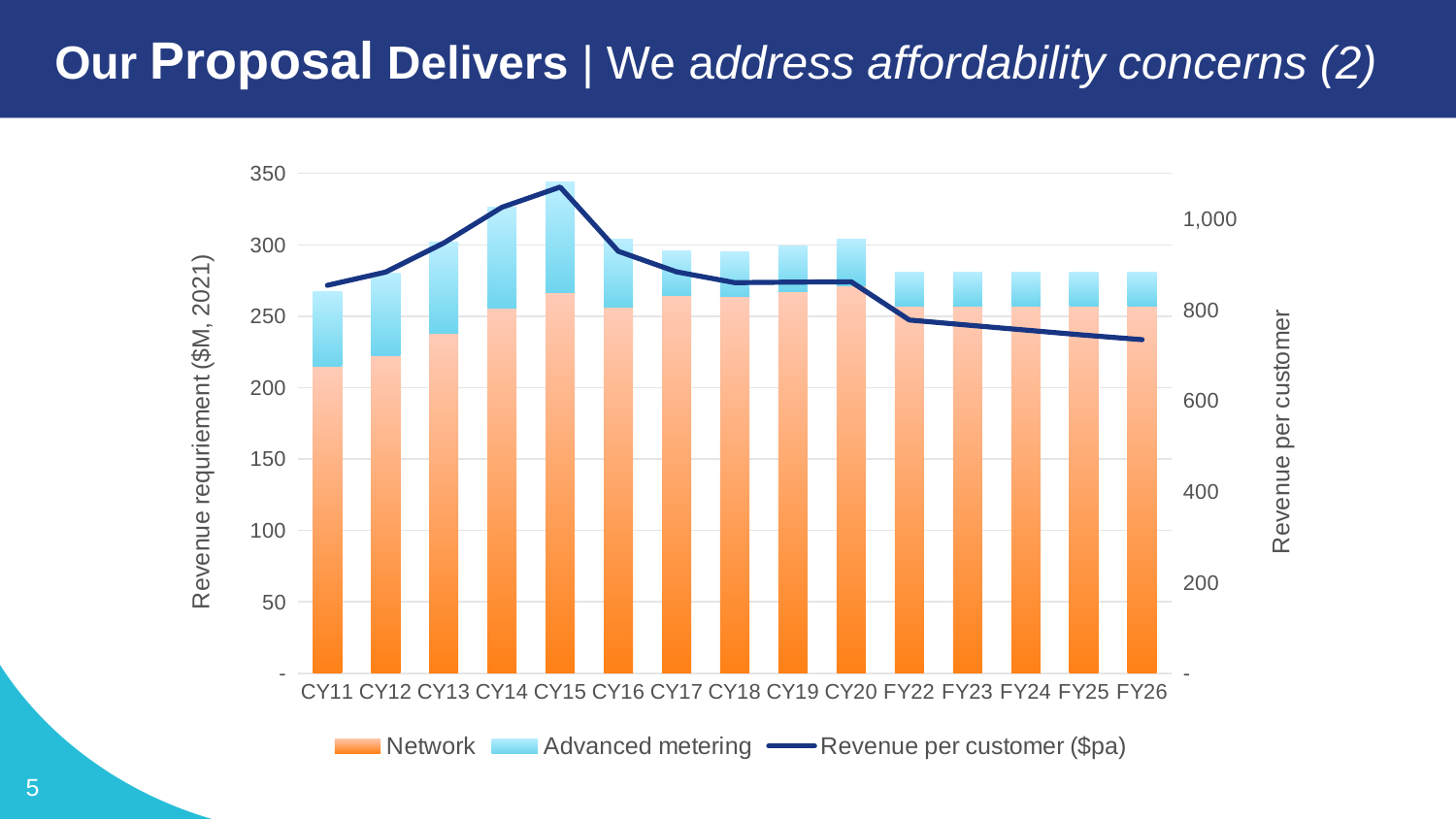
What kind of chart is shown on the slide? A stacked bar chart with a line Which category has the highest total stacked bar? CY15 Which category has the lowest total stacked bar? CY11 How many categories are shown on the x axis? 15 Is the total stacked bar for CY11 greater or less than 300? less In which category does the Revenue per customer line reach its highest point? CY15 Is the total stacked bar for CY15 greater or less than 300? greater Which is larger, the Network value for CY11 or for CY13? CY13 How many series does the legend list? 3 In which category is the Revenue per customer line at its lowest? FY26 Does the Revenue per customer line rise or fall from CY20 to FY26? fall Is the Revenue per customer value for FY26 greater or less than 800? less